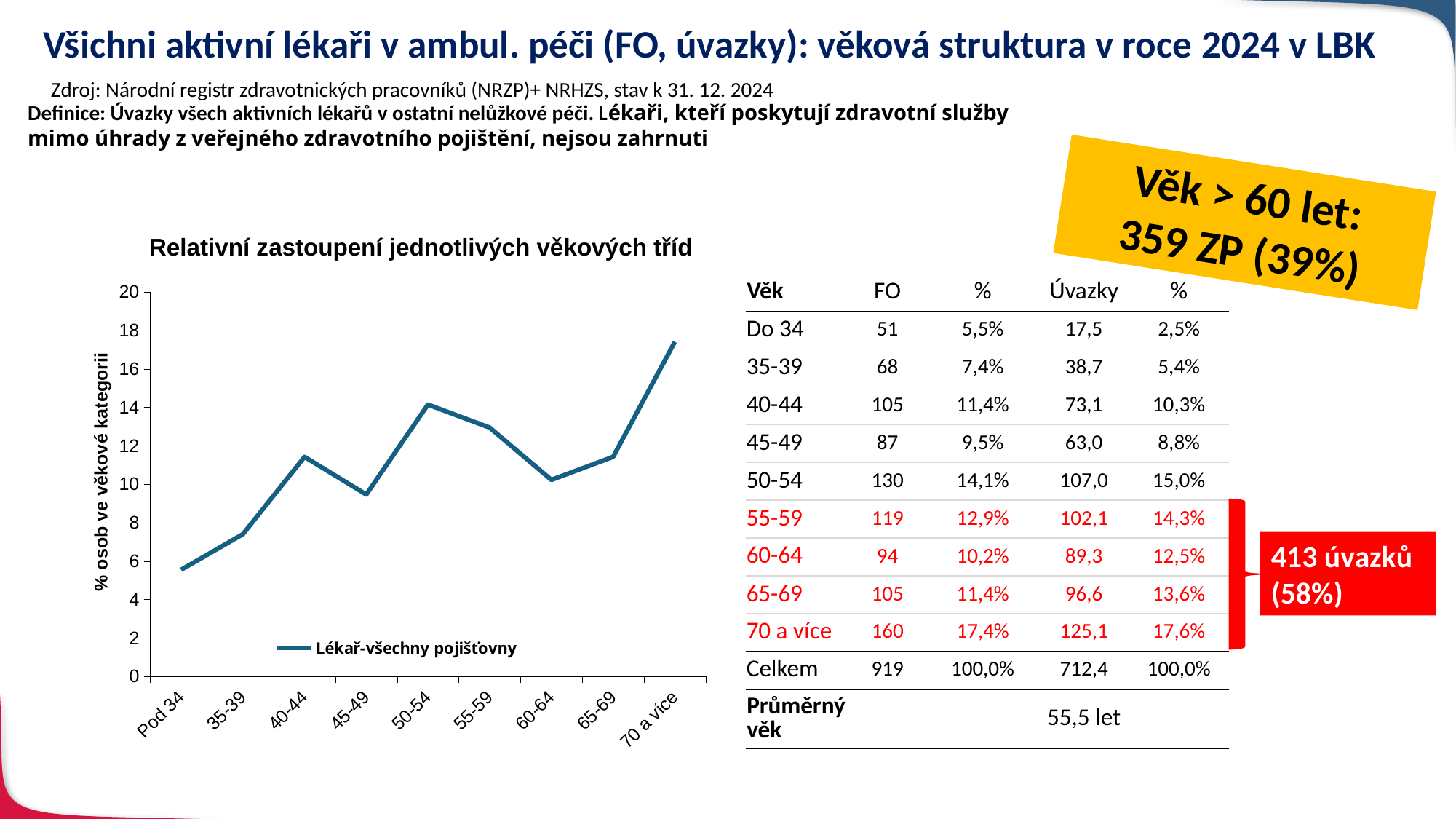
Overall, does the line rise or fall from Pod 34 to 70 a více? rise Which age category has the highest value in the chart? 70 a více Which age category has the lowest value in the chart? Pod 34 How many age categories are plotted along the x axis of the chart? 9 What is the name of the series shown in the chart legend? Lékař-všechny pojišťovny What is the title of the chart? Relativní zastoupení jednotlivých věkových tříd How many series does the chart legend list? 1 Is the value for Pod 34 greater or less than 6? less Which has the larger value in the chart, 50-54 or 55-59? 50-54 What kind of chart is shown on the slide? line chart Is the value for 70 a více greater or less than 16? greater Is the value for 45-49 greater or less than 10? less